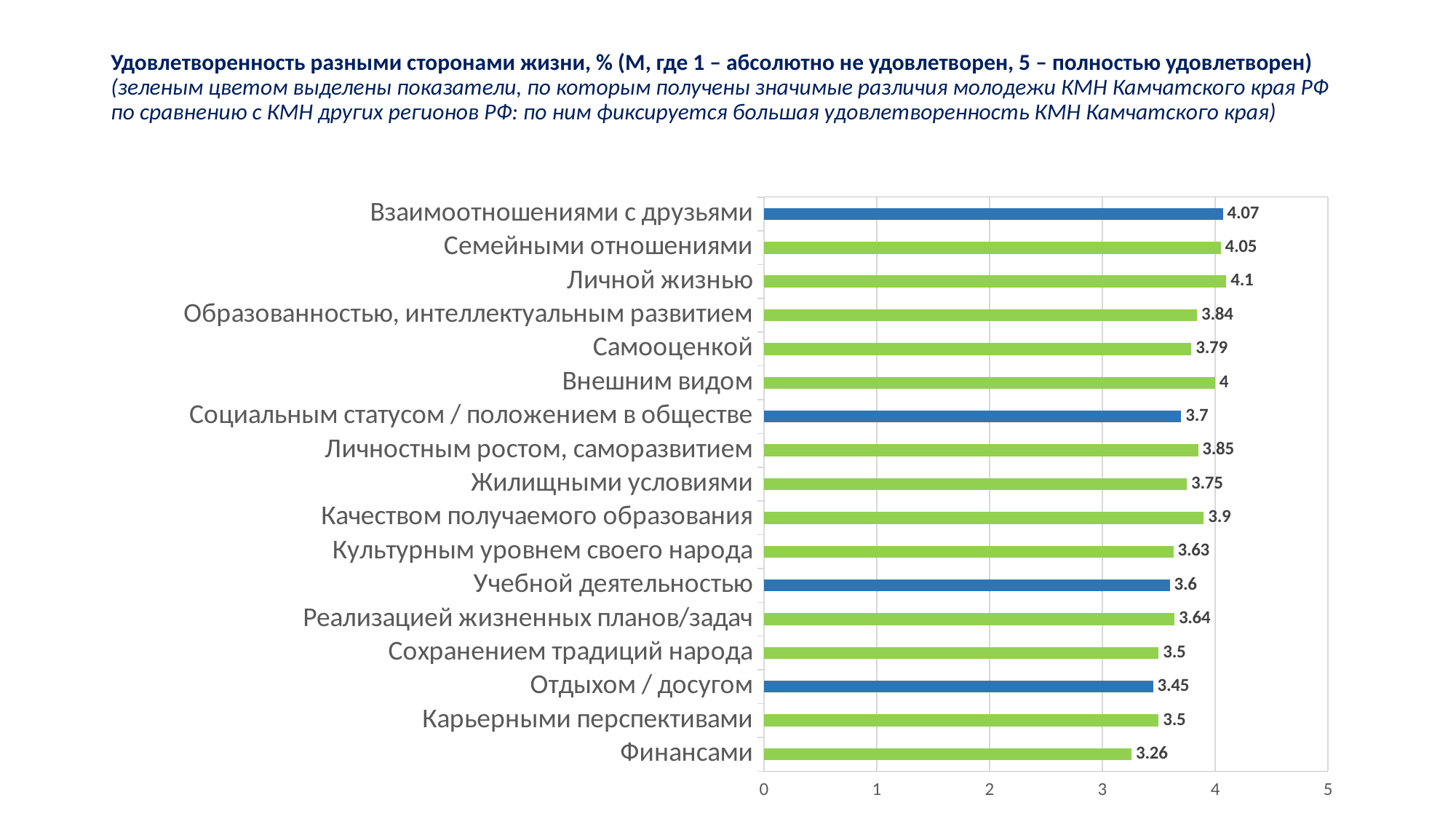
Which is larger: the value for "Самооценкой" or the value for "Жилищными условиями"? Самооценкой What is the value for "Финансами"? 3.26 Is the value for "Отдыхом / досугом" greater or less than 4? less Which category has the lowest value? Финансами What type of chart is shown on the slide? bar chart What colour are the bars for the categories with significant differences for the Kamchatka KMN youth, according to the title? green What is the difference between the values for "Взаимоотношениями с друзьями" and "Финансами"? 0.81 What is the value for "Качеством получаемого образования"? 3.9 Which category has the highest value? Личной жизнью What is the value for "Социальным статусом / положением в обществе"? 3.7 How many categories (aspects of life) are plotted in the chart? 17 What is the value for "Личной жизнью"? 4.1